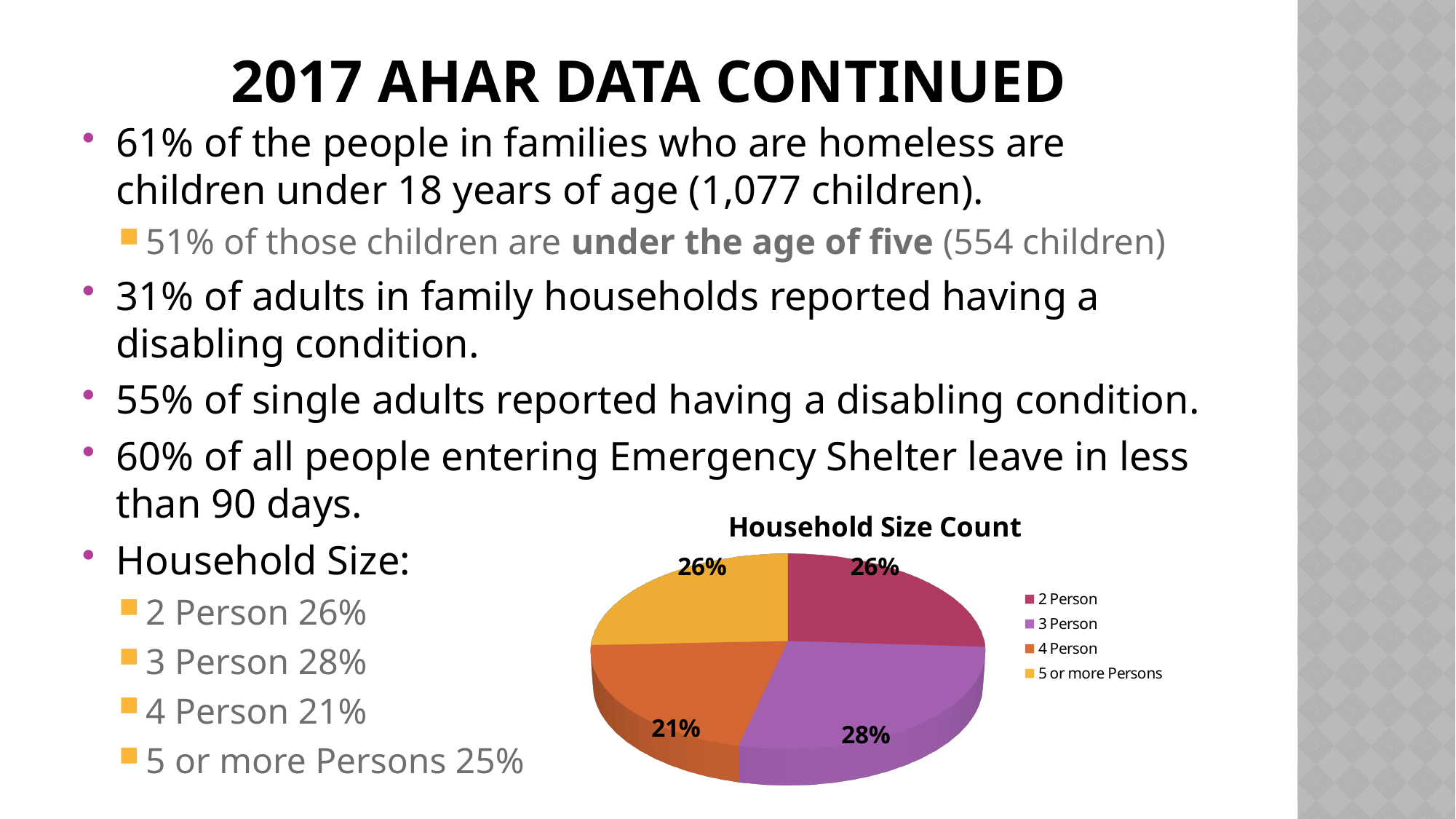
How many entries does the chart legend list? 4 What colour is the 3 Person slice in the pie chart? Purple What type of chart is shown on the slide? Pie chart How many slices does the pie chart have? 4 Which household size category has the largest share of the pie? 3 Person What percentage does the chart show for 4 Person households? 21% What is the difference in percentage points between the 3 Person and 4 Person slices? 7 What percentage does the chart show for 2 Person households? 26% Which household size category has the smallest share of the pie? 4 Person What is the title of the chart? Household Size Count Which slice is larger, 2 Person or 4 Person? 2 Person What percentage does the chart show for 3 Person households? 28%